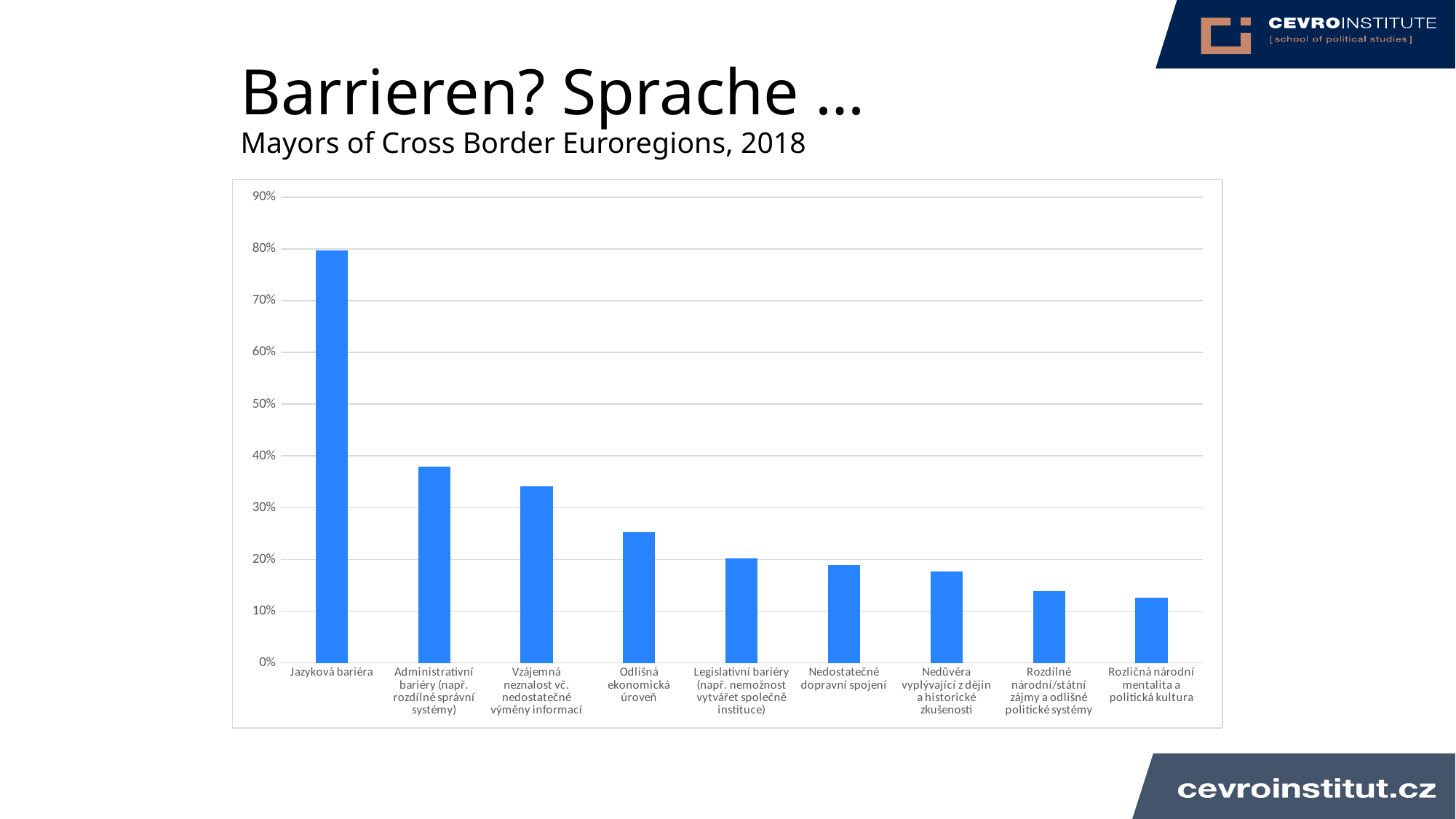
Is the value for Vzájemná neznalost vč. nedostatečné výměny informací greater or less than 30%? greater Is the value for Administrativní bariéry (např. rozdílné správní systémy) greater or less than 40%? less What is the subtitle shown above the chart? Mayors of Cross Border Euroregions, 2018 Which is larger: the value for Odlišná ekonomická úroveň or the value for Legislativní bariéry? Odlišná ekonomická úroveň Is the value for Nedůvěra vyplývající z dějin a historické zkušenosti greater or less than 20%? less Which category has the lowest value in the chart? Rozličná národní mentalita a politická kultura Do the bar values rise or fall from left to right along the x axis? fall Which category has the highest value in the chart? Jazyková bariéra How many categories (barriers) are plotted in the chart? 9 Which is larger: the value for Administrativní bariéry or the value for Vzájemná neznalost? Administrativní bariéry What kind of chart is shown on the slide? bar chart